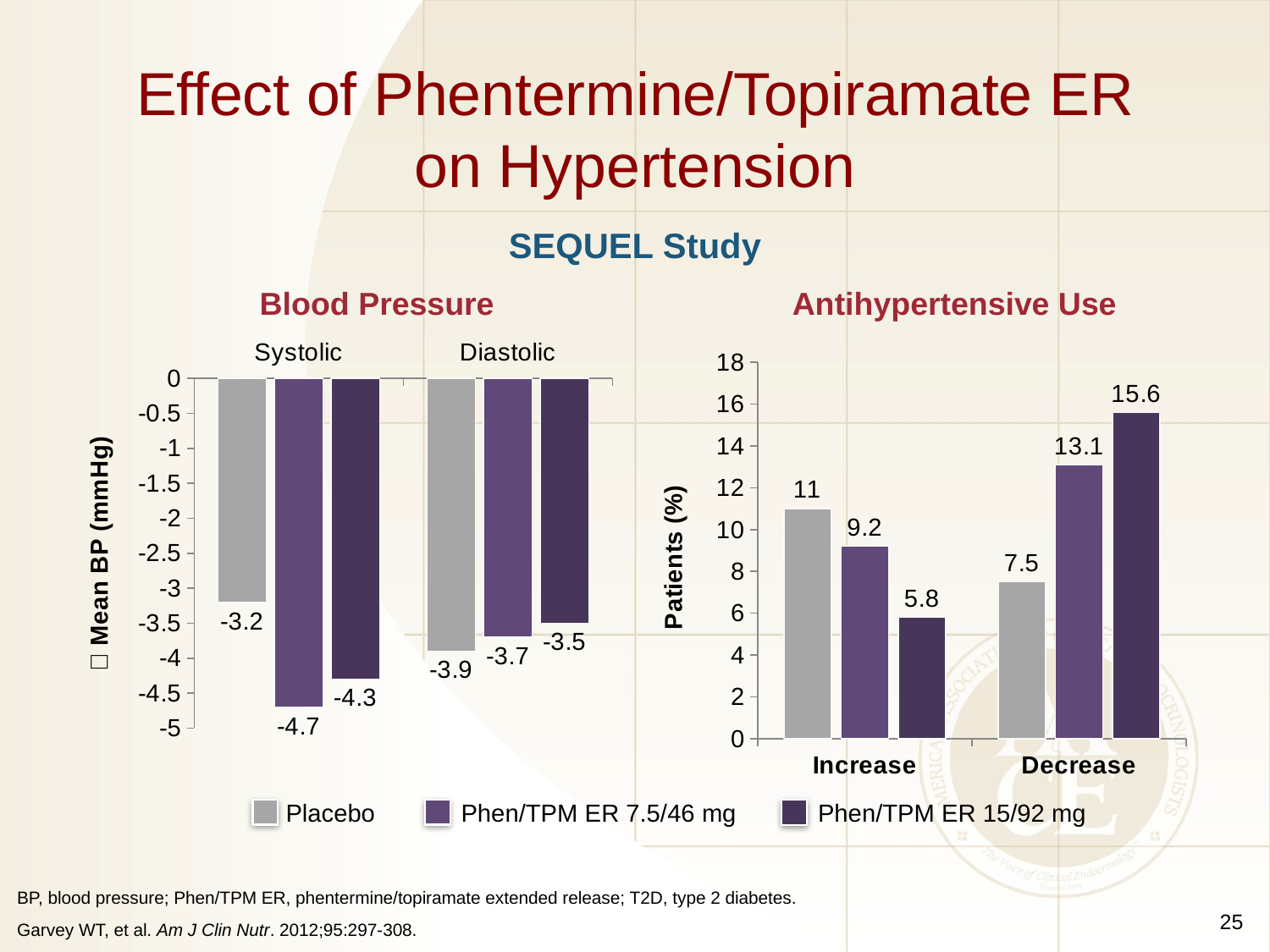
In the Blood Pressure chart, what is the value for Phen/TPM ER 15/92 mg in the Diastolic group? -3.5 What kind of chart is the Antihypertensive Use chart? bar chart How many series does the legend list? 3 In the Blood Pressure chart, what is the value for Phen/TPM ER 7.5/46 mg in the Systolic group? -4.7 In the Antihypertensive Use chart, is the value for Phen/TPM ER 7.5/46 mg in the Increase group larger or smaller than the value for Phen/TPM ER 7.5/46 mg in the Decrease group? smaller In the Antihypertensive Use chart, which series has the highest value in the Decrease group? Phen/TPM ER 15/92 mg In the Antihypertensive Use chart, what is the value for Phen/TPM ER 15/92 mg in the Decrease group? 15.6 In the Antihypertensive Use chart, what is the value for Placebo in the Increase group? 11 In the Antihypertensive Use chart, what is the difference between the Phen/TPM ER 15/92 mg and Placebo values in the Decrease group? 8.1 In the Blood Pressure chart, what is the difference between the Placebo and Phen/TPM ER 7.5/46 mg values in the Systolic group? 1.5 In the Blood Pressure chart, what is the value for Placebo in the Systolic group? -3.2 In the Antihypertensive Use chart, which series has the lowest value in the Increase group? Phen/TPM ER 15/92 mg